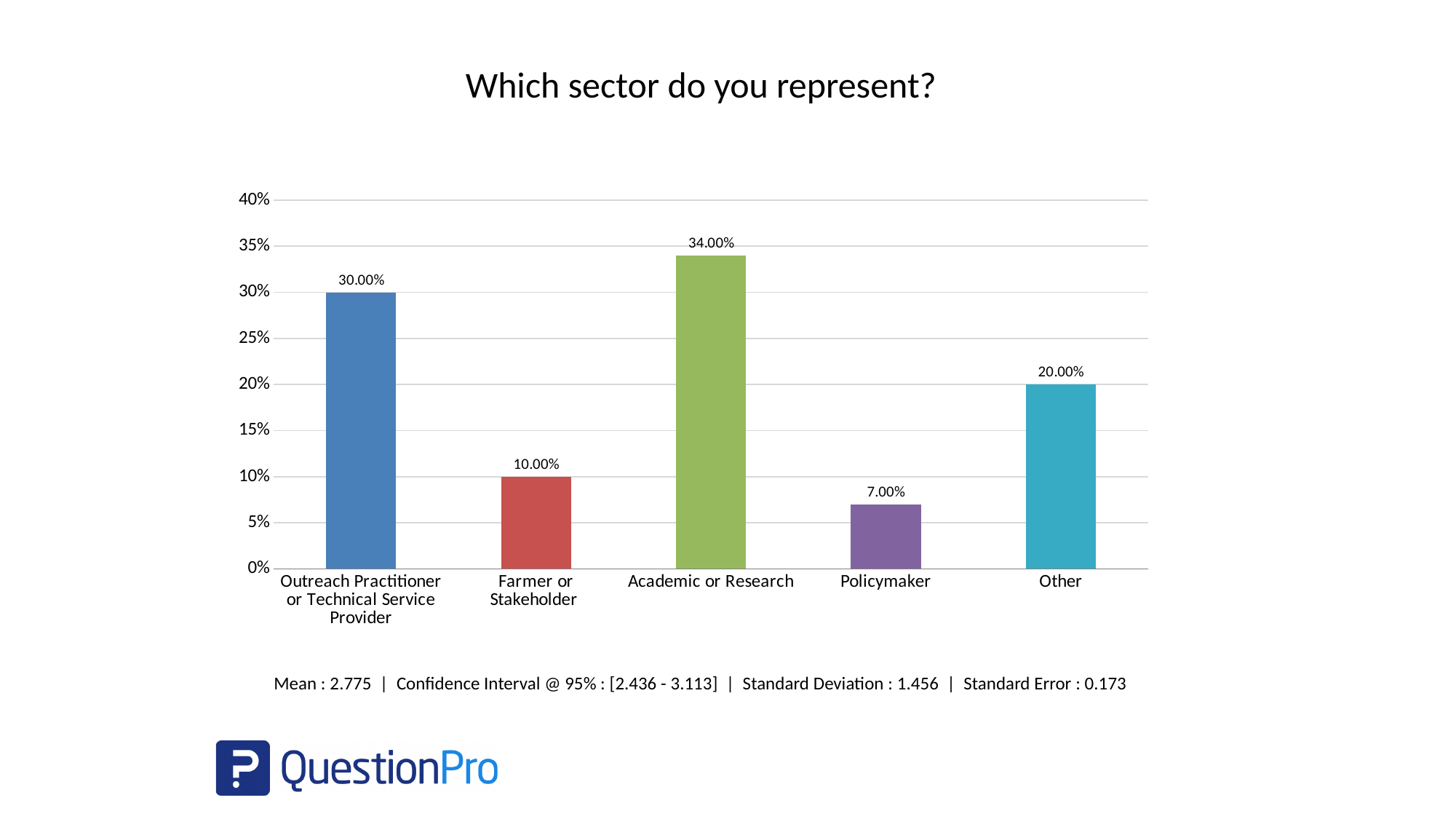
What is the difference between the Other value and the Farmer or Stakeholder value? 10.00% Which is larger, the value for Other or the value for Farmer or Stakeholder? Other How many sectors are shown on the chart? 5 What is the value shown for Policymaker? 7.00% Which sector has the lowest percentage? Policymaker Is the value for Other greater or less than 25%? less Which sector has the highest percentage? Academic or Research What kind of chart is shown on the slide? bar chart What is the difference between the Academic or Research value and the Outreach Practitioner or Technical Service Provider value? 4.00% What is the title of the chart? Which sector do you represent? What percentage is shown for Outreach Practitioner or Technical Service Provider? 30.00% What percentage of respondents represent the Academic or Research sector? 34.00%